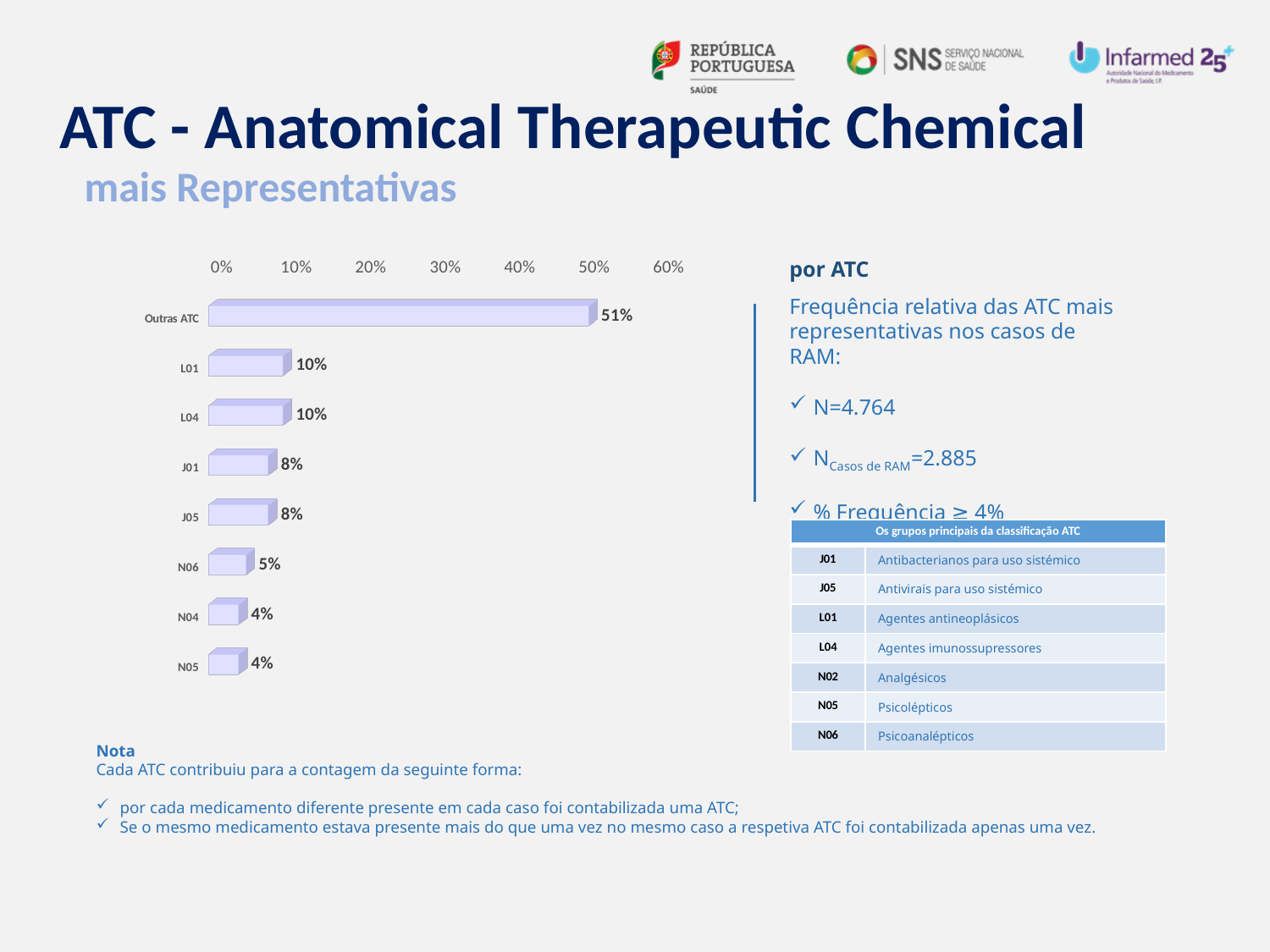
What is the value for N06? 5% What is the value for L04? 10% What is the value for Outras ATC? 51% Which is larger, the value for N06 or the value for N05? N06 How many categories are shown in the chart? 8 What is the value for J05? 8% What kind of chart is shown on the slide? bar chart What is the highest value shown on the chart's percentage axis? 60% What is the difference between the values for J01 and N04? 4% What is the difference between the values for Outras ATC and L01? 41% Is the value for Outras ATC greater or less than 50%? greater Which category has the highest value? Outras ATC